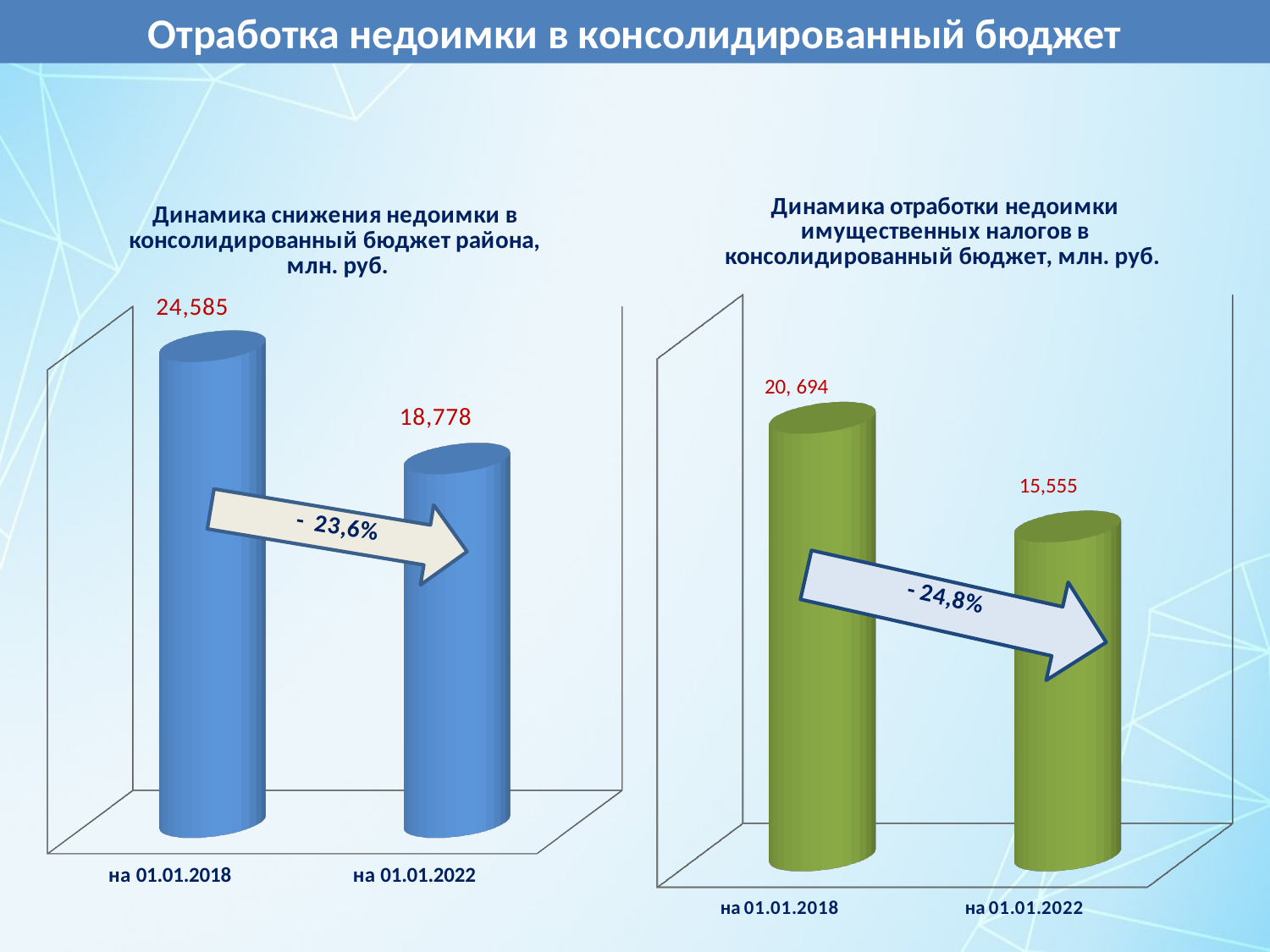
On the right chart, which date has the lower value? на 01.01.2022 On the right chart (Динамика отработки недоимки имущественных налогов), what is the value for на 01.01.2018? 20, 694 On the right chart, what is the difference between the value for на 01.01.2018 and the value for на 01.01.2022? 5,139 On the left chart (Динамика снижения недоимки в консолидированный бюджет района), what is the value for на 01.01.2022? 18,778 On the left chart, what is the difference between the value for на 01.01.2018 and the value for на 01.01.2022? 5,807 How many categories (dates) are shown on the left chart? 2 On the left chart, which date has the higher value? на 01.01.2018 What kind of chart is the right chart? bar chart On the right chart (Динамика отработки недоимки имущественных налогов), what is the value for на 01.01.2022? 15,555 On the left chart (Динамика снижения недоимки в консолидированный бюджет района), what is the value for на 01.01.2018? 24,585 What percentage change is printed on the arrow in the left chart? - 23,6% On the right chart, do the values rise or fall from на 01.01.2018 to на 01.01.2022? fall